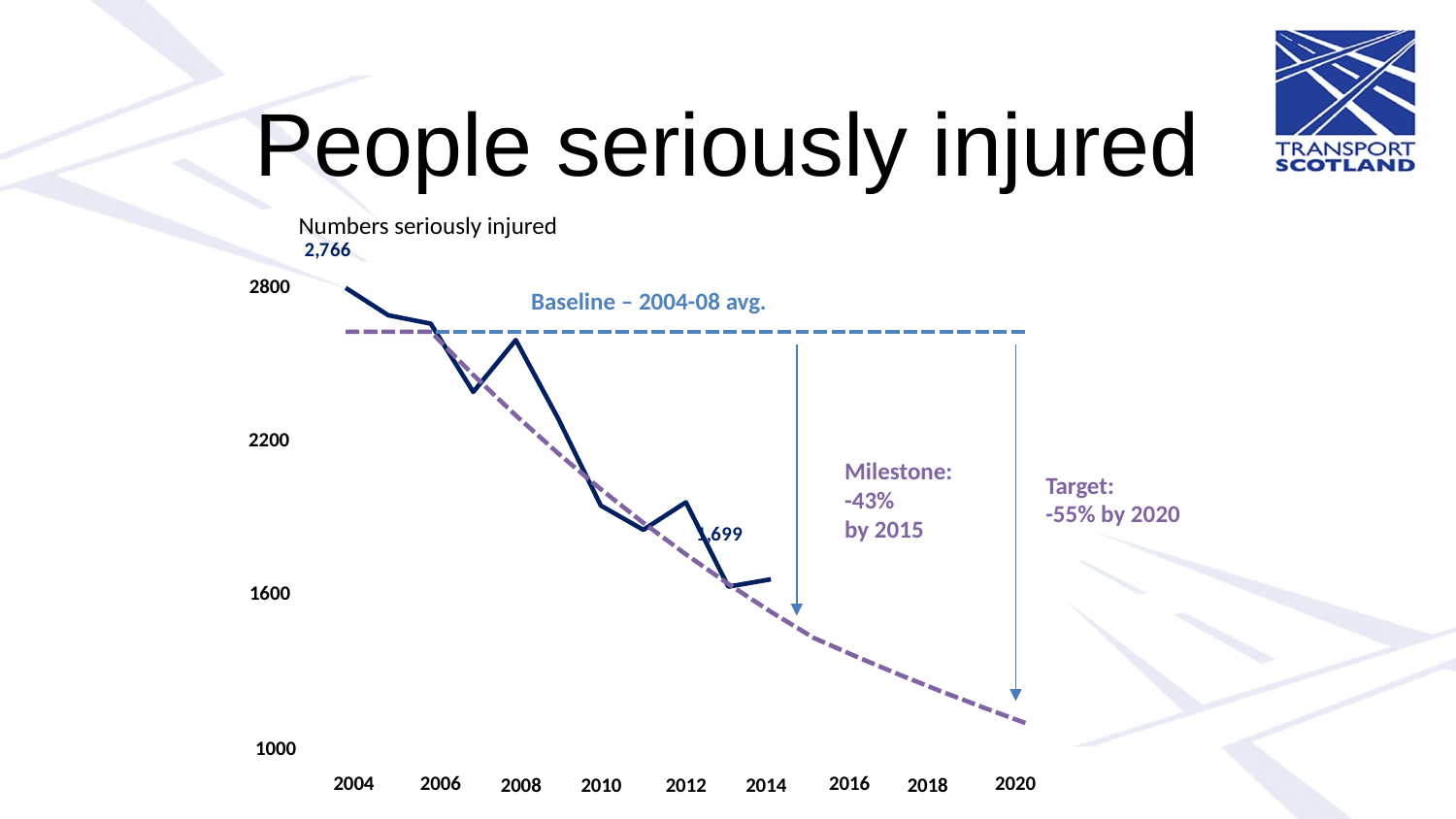
Is the value for 2010 greater or less than 2200? less Is the value for 2008 greater or less than 2200? greater Which year has the highest number of people seriously injured? 2004 What kind of chart is shown on the slide? line chart What is the target reduction by 2020 stated on the chart? -55% by 2020 Do the numbers seriously injured generally rise or fall from 2004 to 2014? fall Which is larger, the value for 2008 or the value for 2010? 2008 What is the lower data label printed on the solid line, near 2012–2013? 1,699 How many year labels are shown on the x axis? 9 What value is labelled at the start of the line, for 2004? 2,766 Is the value for 2014 greater or less than 2200? less What period does the dashed baseline represent, according to its label? 2004-08 avg.